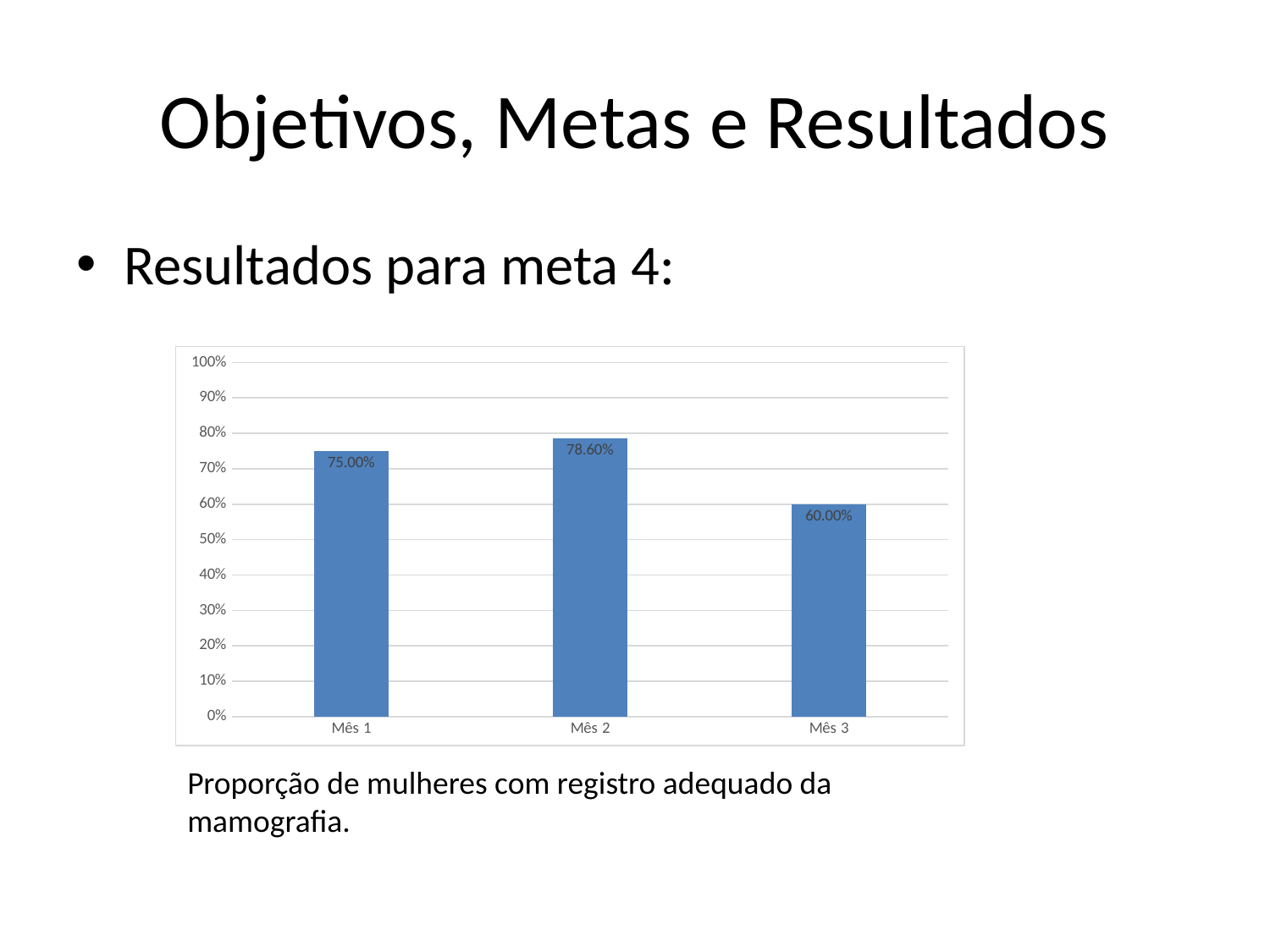
What is the value for Mês 3? 60.00% Is the value for Mês 3 greater or less than 70%? less What kind of chart is shown on the slide? bar chart How many months are shown on the x axis? 3 What is the difference between the values for Mês 2 and Mês 1? 3.60% What is the difference between the values for Mês 2 and Mês 3? 18.60% Which month has the highest value? Mês 2 Which is larger, the value for Mês 1 or the value for Mês 3? Mês 1 What is the value for Mês 2? 78.60% What is the highest value shown on the y axis? 100% What is the value for Mês 1? 75.00% Which month has the lowest value? Mês 3